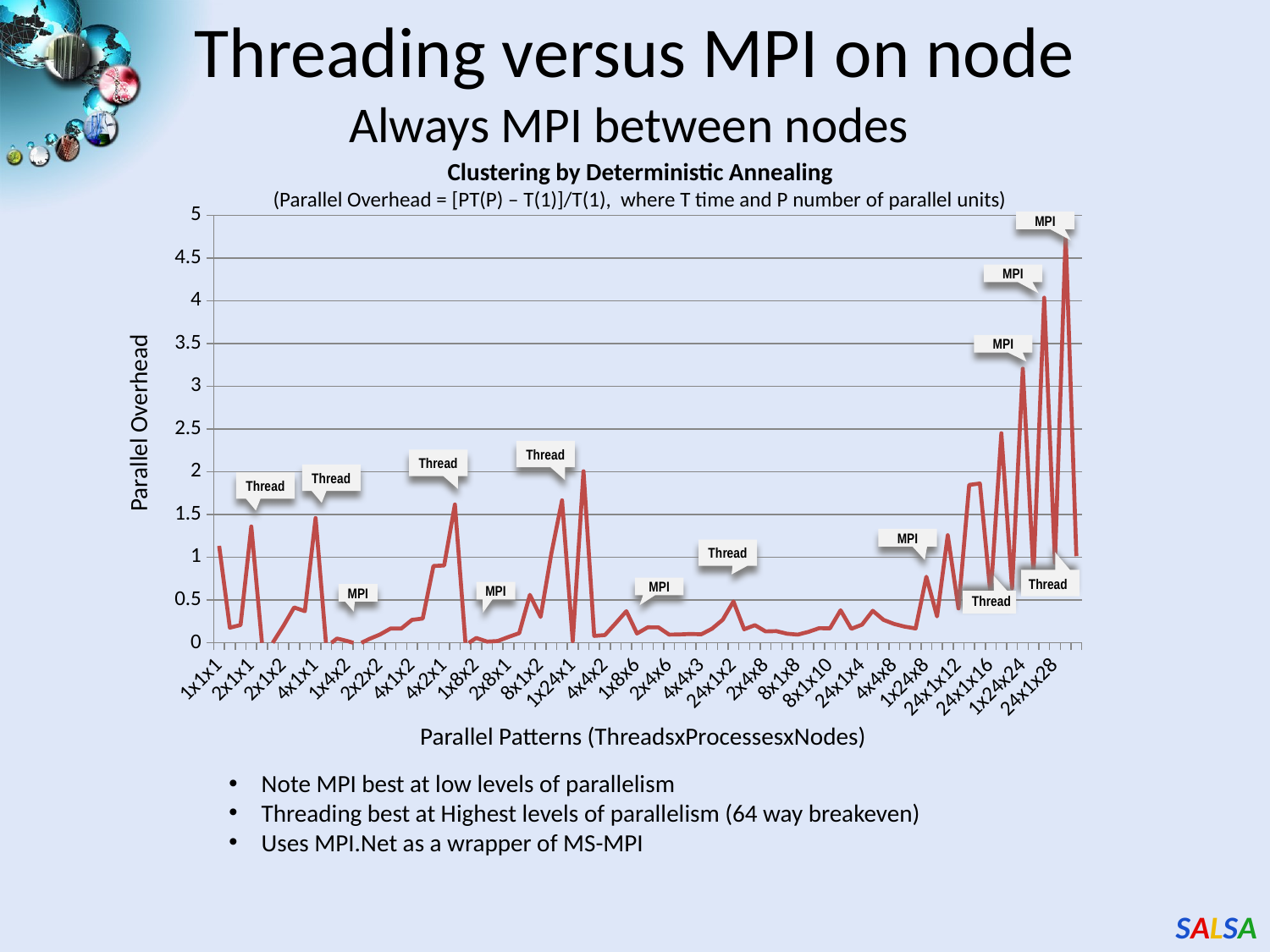
Is the lowest value on the chart greater or less than 0.5? less Is the value for 1x1x1 greater or less than 0.5? greater What is the title of the chart? Clustering by Deterministic Annealing Is the value for 1x1x1 greater or less than 2? less What is the label of the vertical axis of the chart? Parallel Overhead What kind of chart is shown on the slide? line chart Do the peak values of the line rise or fall toward the right end of the x axis? rise